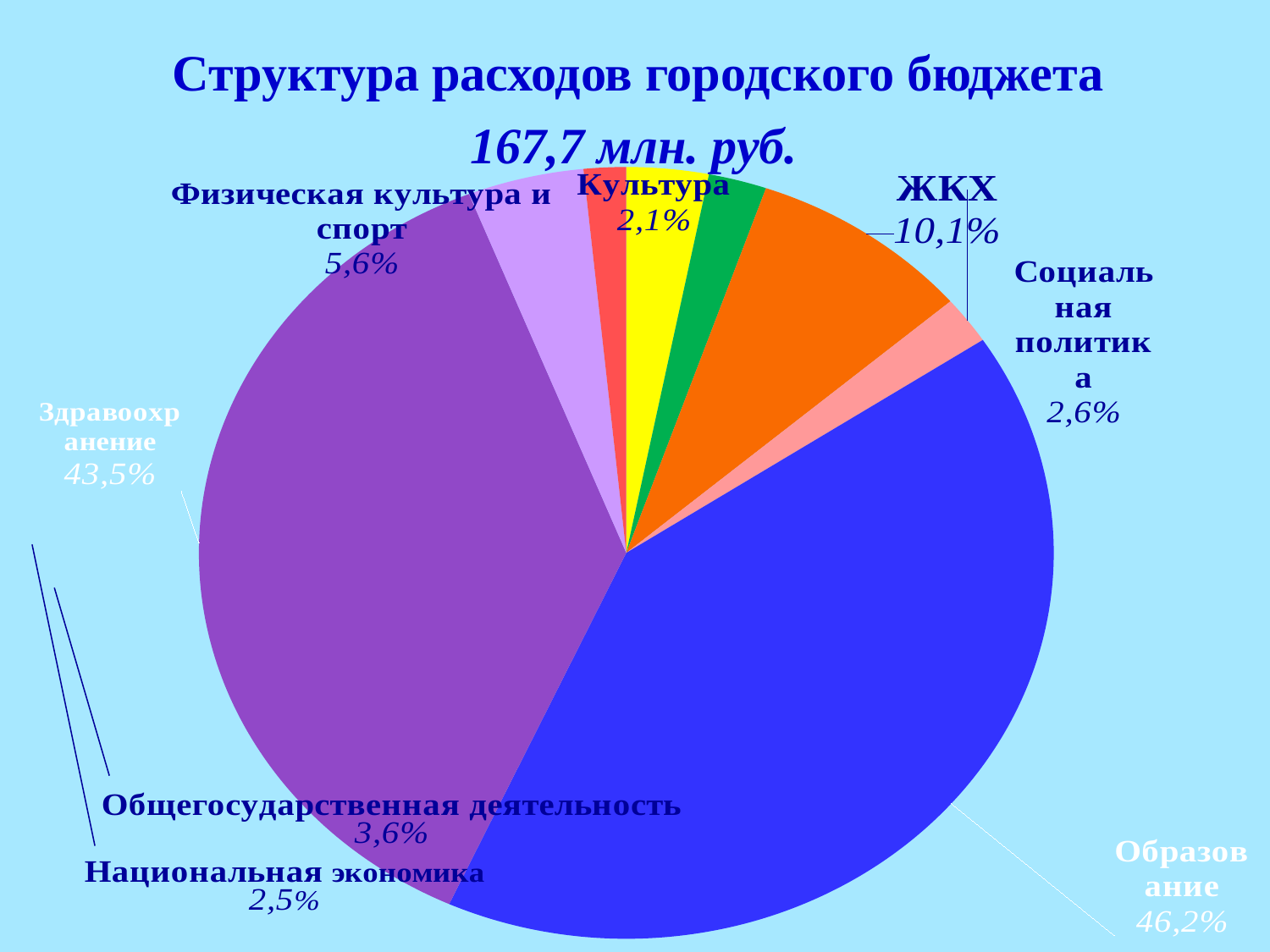
Which category has the largest share of the pie? Образование What is the difference in percentage points between Образование and Здравоохранение? 2,7 What kind of chart is shown on the slide? pie chart Which category has the smallest share of the pie? Культура What is the title of the chart? Структура расходов городского бюджета 167,7 млн. руб. What share of the pie does Здравоохранение have? 43,5% What is the value shown for Культура? 2,1% What is the value shown for ЖКХ? 10,1% Which is larger, the share for ЖКХ or the share for Общегосударственная деятельность? ЖКХ How many categories (slices) does the pie chart have? 8 What is the value shown for Физическая культура и спорт? 5,6% What share of the pie does Образование have? 46,2%